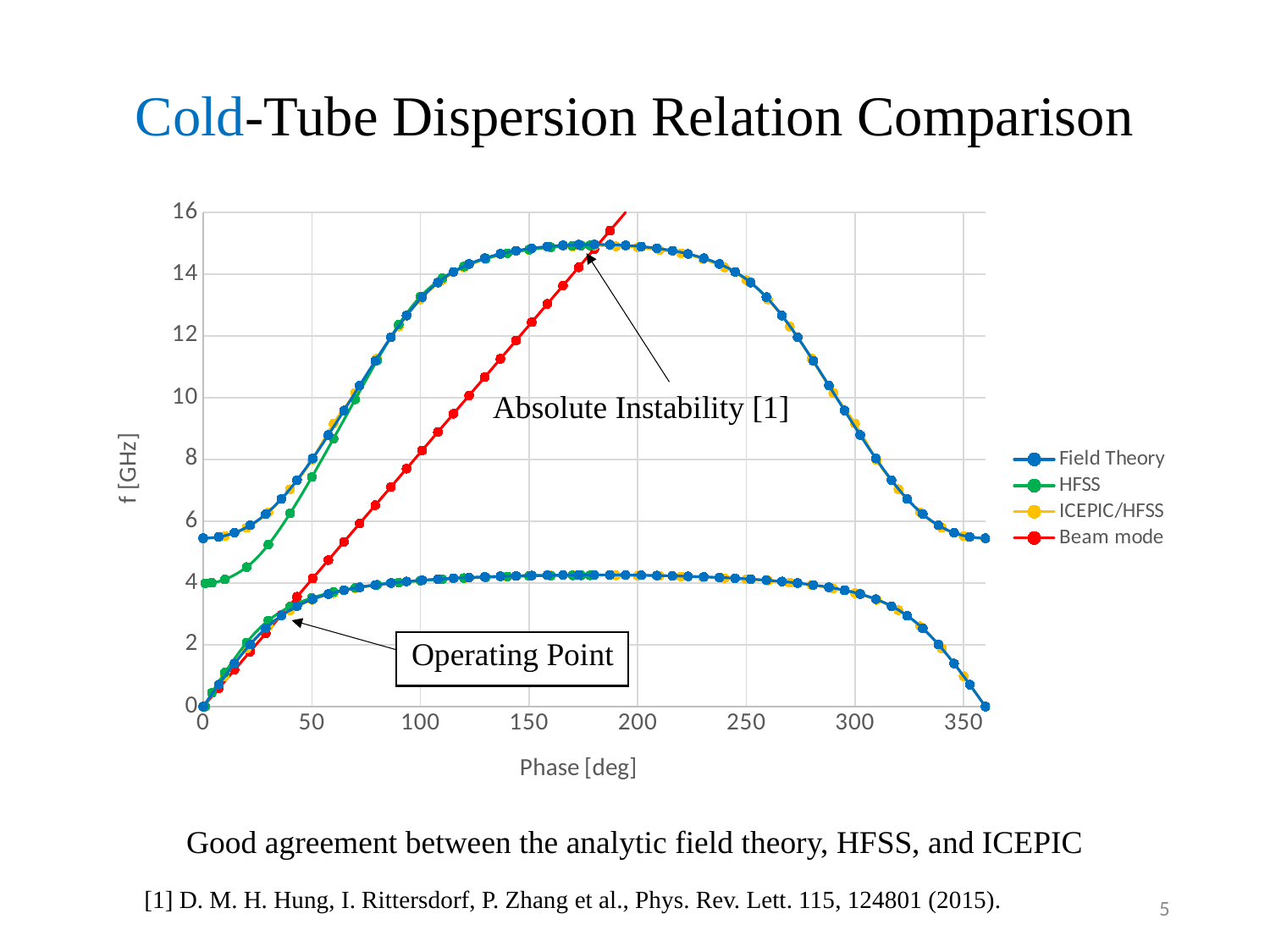
At a phase of 100 degrees, which is larger: the upper Field Theory branch or the Beam mode? Field Theory How many series does the legend list? 4 What is the title of the x axis? Phase [deg] Does the Beam mode series rise or fall as phase increases? rises Is the Beam mode value at a phase of 150 degrees greater or less than 12 GHz? greater What is the title of the y axis? f [GHz] Is the maximum value of the lower Field Theory branch greater or less than 6 GHz? less Is the value of the upper Field Theory branch at a phase of 0 degrees greater or less than 6 GHz? less Which series reaches the highest frequency on the chart? Beam mode What kind of chart is shown on the slide? line chart At a phase of 300 degrees, which is larger: the upper Field Theory branch or the lower Field Theory branch? upper branch